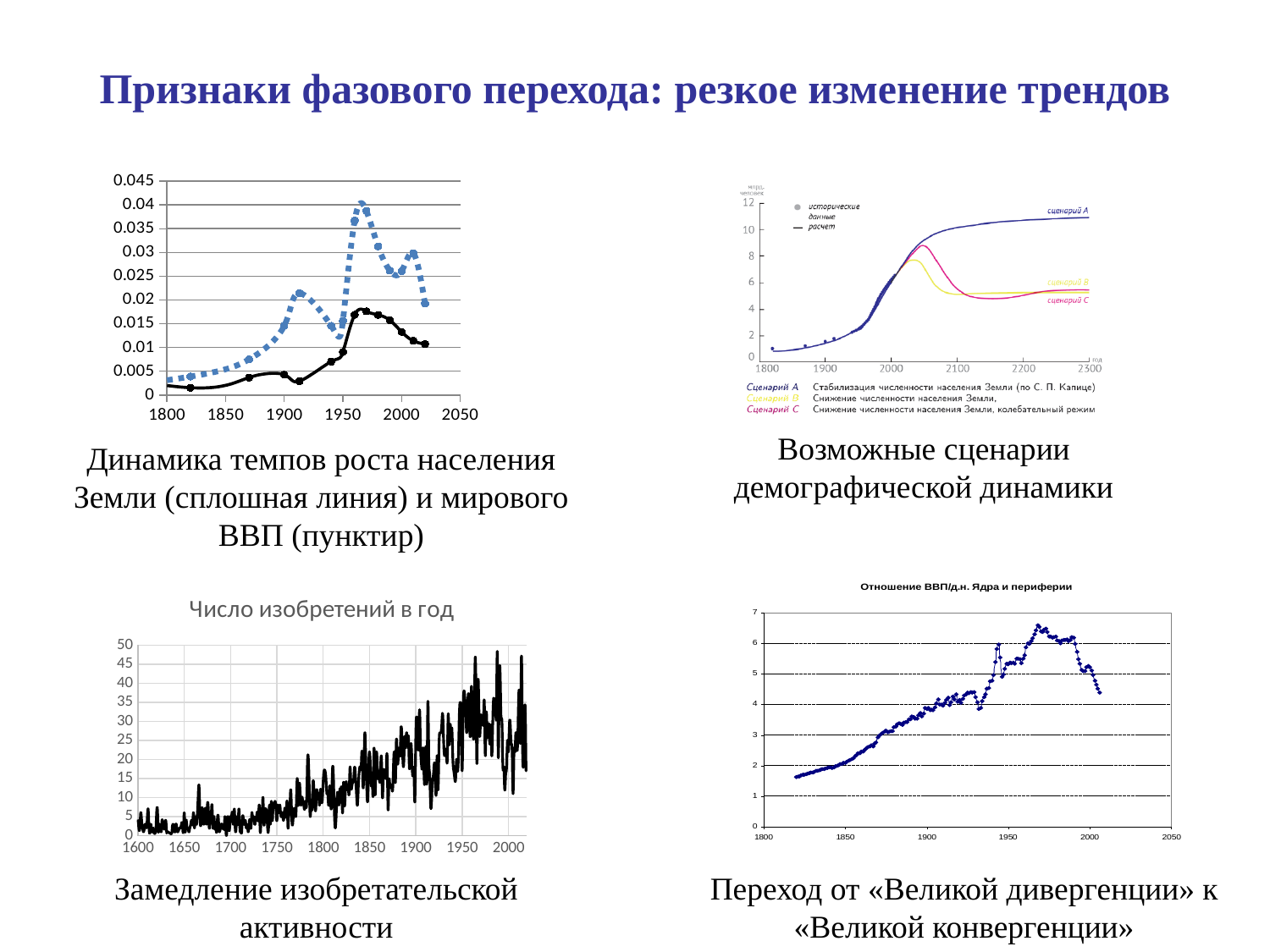
In the top-left chart of population growth rate and world GDP, which line reaches a higher peak, the solid line or the dotted line? the dotted line In the top-right chart "Возможные сценарии демографической динамики", which scenario has the highest value at 2300? сценарий A In the top-right chart "Возможные сценарии демографической динамики", is the value of scenario A at 2300 greater or less than 10? greater In the bottom-left chart "Число изобретений в год", what is the highest value shown on the vertical axis? 50 In the bottom-right chart "Отношение ВВП/д.н. Ядра и периферии", is the peak value around 1970 greater or less than 6? greater In the top-right chart "Возможные сценарии демографической динамики", how many scenarios are plotted? 3 In the top-left chart of population growth rate and world GDP, is the peak value of the dotted line (world GDP) greater or less than 0.035? greater In the bottom-left chart "Число изобретений в год", do the values generally rise or fall from 1600 to 2000? rise What kind of chart is the bottom-left chart titled "Число изобретений в год"? line chart